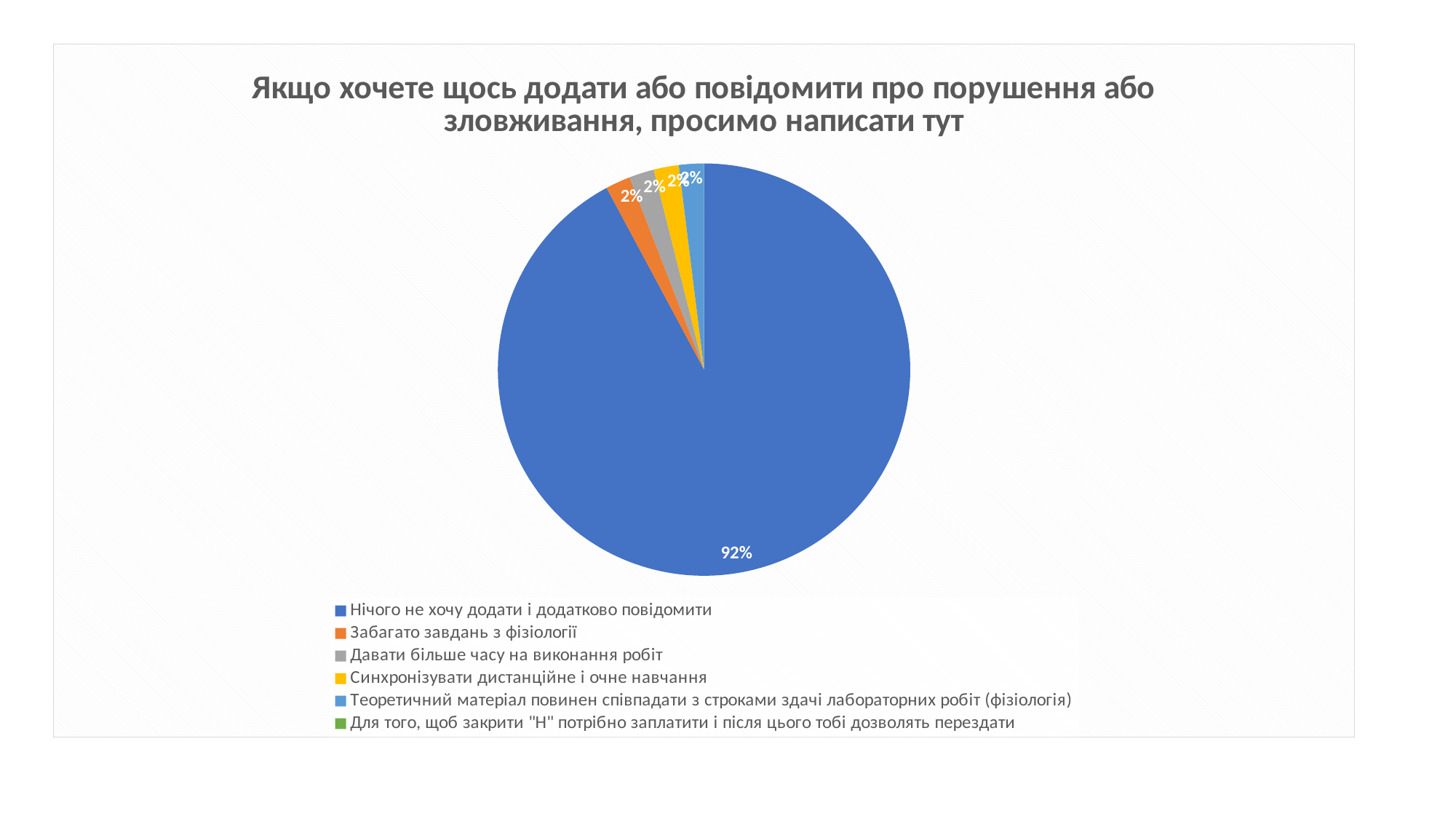
What is the difference in percentage points between "Нічого не хочу додати і додатково повідомити" and "Забагато завдань з фізіології"? 90 What is the value shown for "Теоретичний матеріал повинен співпадати з строками здачі лабораторних робіт (фізіологія)"? 2% How many entries does the legend list? 6 What is the value shown for "Синхронізувати дистанційне і очне навчання"? 2% What kind of chart is shown on the slide? pie chart Which is larger: the share for "Нічого не хочу додати і додатково повідомити" or the share for "Синхронізувати дистанційне і очне навчання"? Нічого не хочу додати і додатково повідомити What share of the pie does "Нічого не хочу додати і додатково повідомити" have? 92% What is the title of the chart? Якщо хочете щось додати або повідомити про порушення або зловживання, просимо написати тут Which category has the largest share of the pie? Нічого не хочу додати і додатково повідомити What colour is the largest slice of the pie? blue What is the value shown for "Давати більше часу на виконання робіт"? 2% What is the value shown for "Забагато завдань з фізіології"? 2%